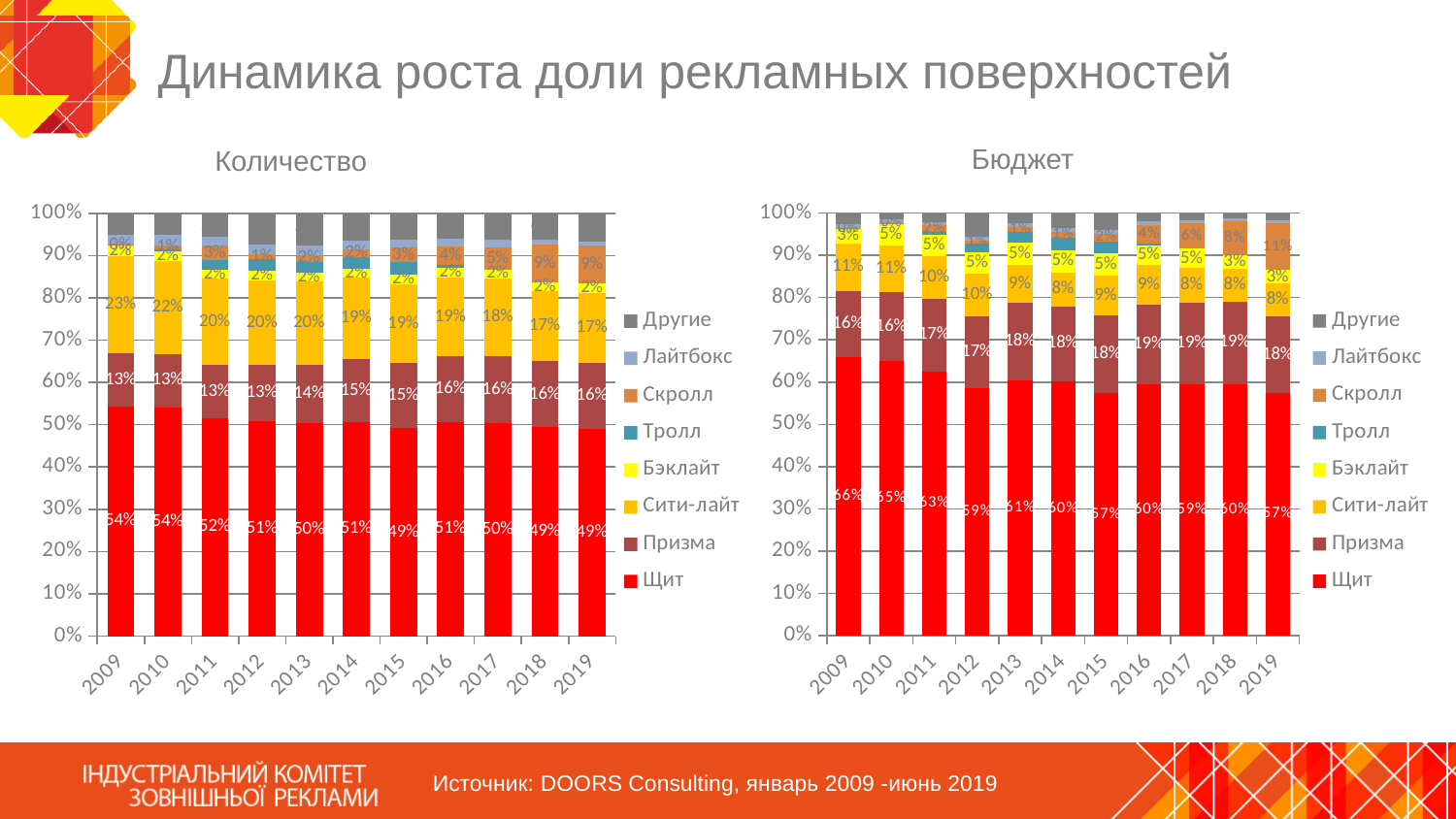
In the "Бюджет" chart, which is larger: the Щит value in 2009 or in 2019? 2009 In the "Бюджет" chart, what is the value for Щит in 2009? 66% What kind of chart is the "Количество" chart? stacked bar chart Which series is shown in red in both charts? Щит In the "Количество" chart, what is the value for Сити-лайт in 2019? 17% In the "Количество" chart, what is the difference between the Сити-лайт values for 2009 and 2019? 6% In the "Бюджет" chart, which year has the highest Щит value? 2009 In the "Количество" chart, what is the value for Щит in 2009? 54% In the "Количество" chart, does the Сити-лайт share rise or fall from 2009 to 2019? fall In the "Бюджет" chart, what is the value for Призма in 2016? 19% How many years are shown on the x axis of the "Количество" chart? 11 How many series does the legend of the "Бюджет" chart list? 8